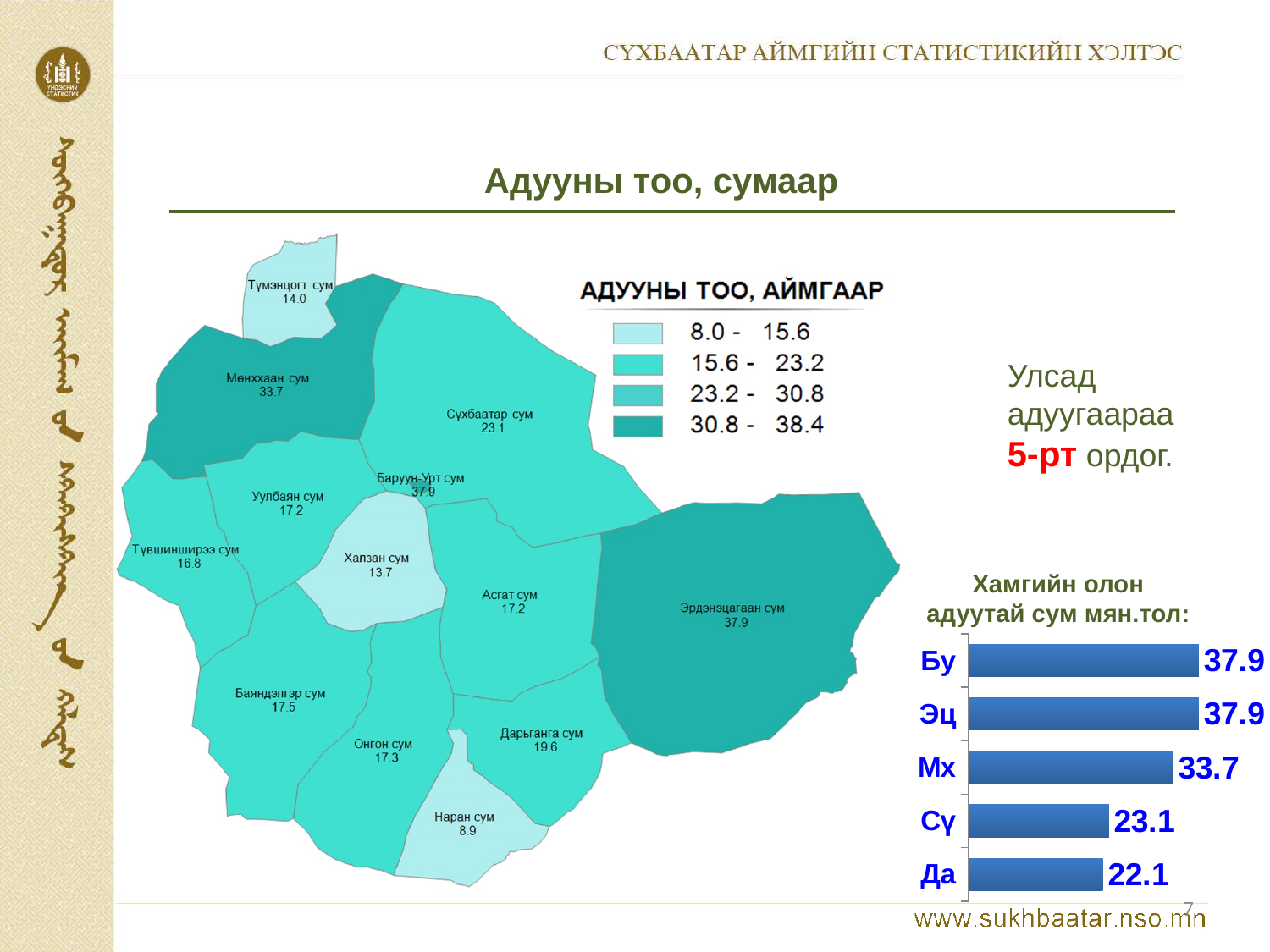
In the bar chart 'Хамгийн олон адуутай сум мян.тол:', what is the difference between the values for Мх and Сү? 10.6 In the bar chart 'Хамгийн олон адуутай сум мян.тол:', what is the difference between the values for Бу and Да? 15.8 In the bar chart 'Хамгийн олон адуутай сум мян.тол:', what is the value for Да? 22.1 In the bar chart 'Хамгийн олон адуутай сум мян.тол:', what is the value for Мх? 33.7 In the bar chart 'Хамгийн олон адуутай сум мян.тол:', what is the value for Сү? 23.1 On the map 'Адууны тоо, сумаар', how many value ranges does the legend 'АДУУНЫ ТОО, АЙМГААР' list? 4 In the bar chart 'Хамгийн олон адуутай сум мян.тол:', which category has the lowest value? Да What kind of chart is 'Хамгийн олон адуутай сум мян.тол:'? bar chart On the map 'Адууны тоо, сумаар', what value is shown for Эрдэнэцагаан сум? 37.9 In the bar chart 'Хамгийн олон адуутай сум мян.тол:', which is larger, the value for Мх or the value for Сү? Мх How many categories are shown in the bar chart 'Хамгийн олон адуутай сум мян.тол:'? 5 In the bar chart 'Хамгийн олон адуутай сум мян.тол:', do the values rise or fall from the top bar to the bottom bar? fall